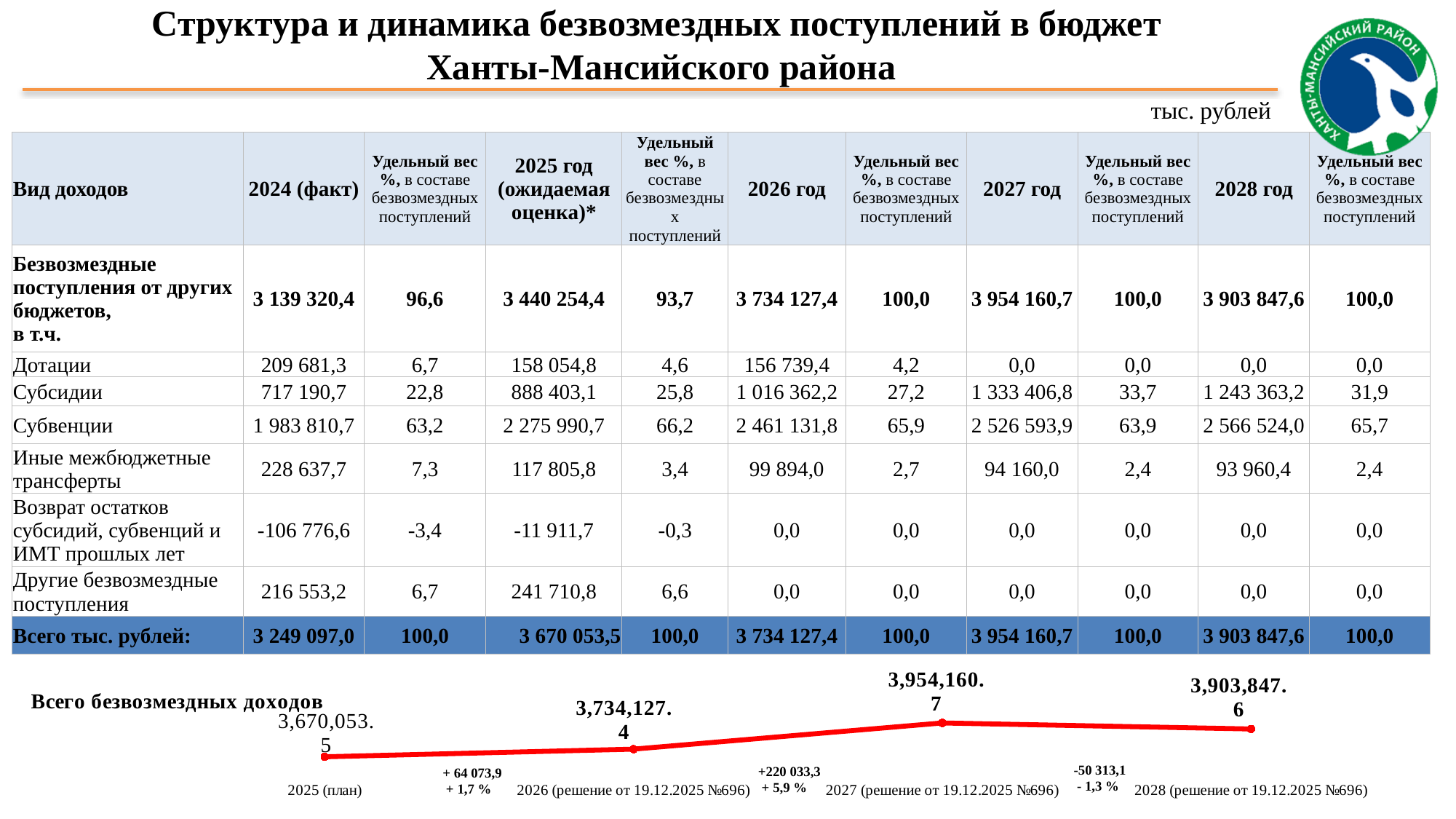
In the line chart, what is the value for 2026? 3,734,127.4 In the line chart, is the value for 2027 larger or smaller than the value for 2028? larger What is the title of the line chart at the bottom of the slide? Всего безвозмездных доходов How many data points are plotted in the line chart? 4 In the line chart, what is the value for 2025 (план)? 3,670,053.5 In the line chart, which year has the highest value? 2027 In the line chart, what is the change shown between 2027 and 2028? -50 313,1 In the line chart, what is the change shown between 2026 and 2027? +220 033,3 In the line chart, what is the value for 2027? 3,954,160.7 What kind of chart is shown at the bottom of the slide? line chart In the line chart, which year has the lowest value? 2025 (план) In the line chart, what is the value for 2028? 3,903,847.6